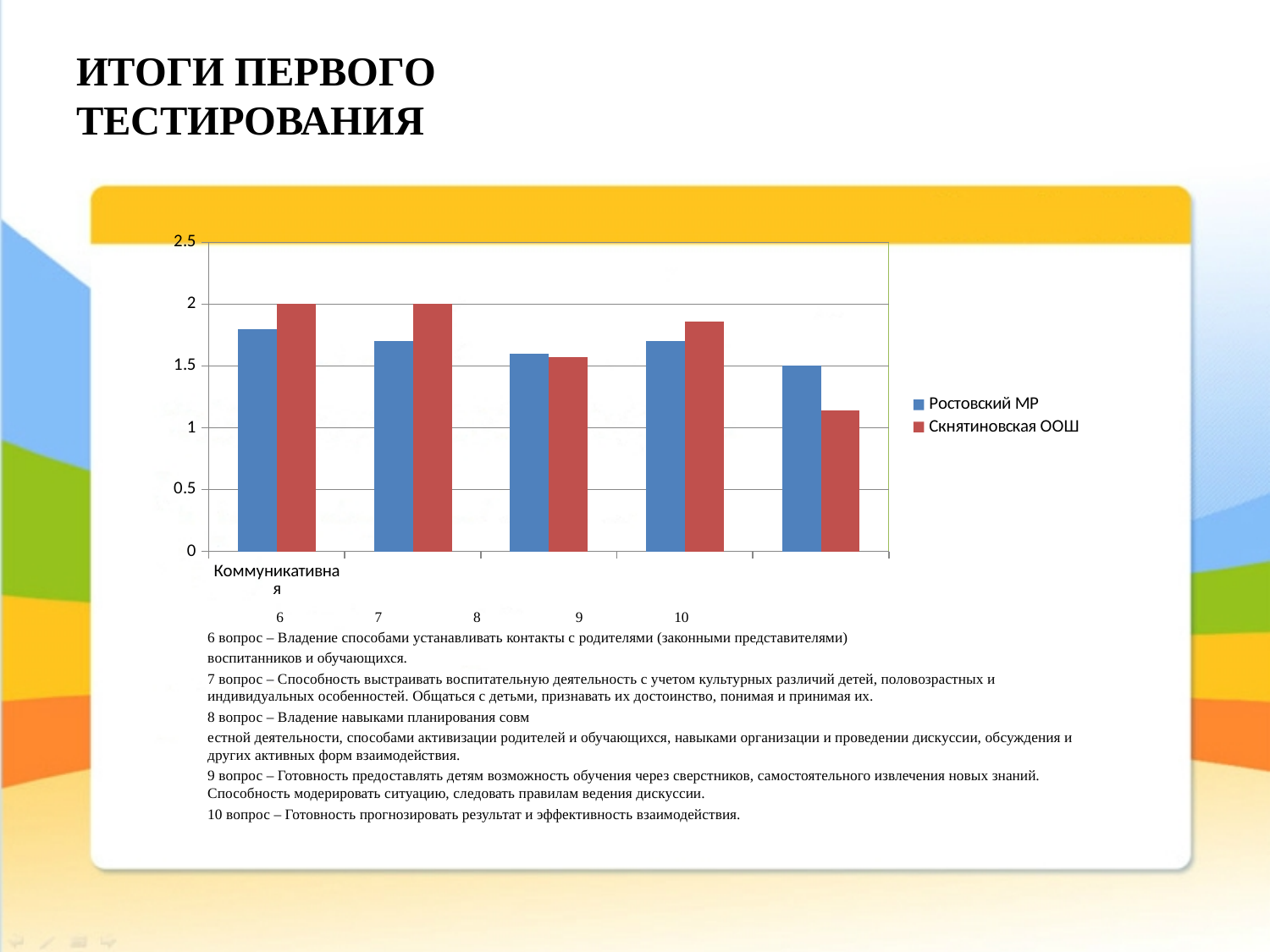
Is the value for Ростовский МР on question 6 greater or less than 1.5? greater For which question is the Ростовский МР value the highest? 6 On question 10, which series has the larger value, Ростовский МР or Скнятиновская ООШ? Ростовский МР Is the value for Скнятиновская ООШ on question 9 greater or less than 1.5? greater What is the value for Скнятиновская ООШ on question 6? 2 Is the value for Скнятиновская ООШ on question 10 greater or less than 1.5? less How many series does the legend list? 2 How many groups of bars (questions) are plotted on the chart? 5 On question 6, which series has the larger value, Ростовский МР or Скнятиновская ООШ? Скнятиновская ООШ For which question is the Скнятиновская ООШ value the lowest? 10 Which two series are listed in the chart legend? Ростовский МР and Скнятиновская ООШ What kind of chart is shown on the slide? bar chart